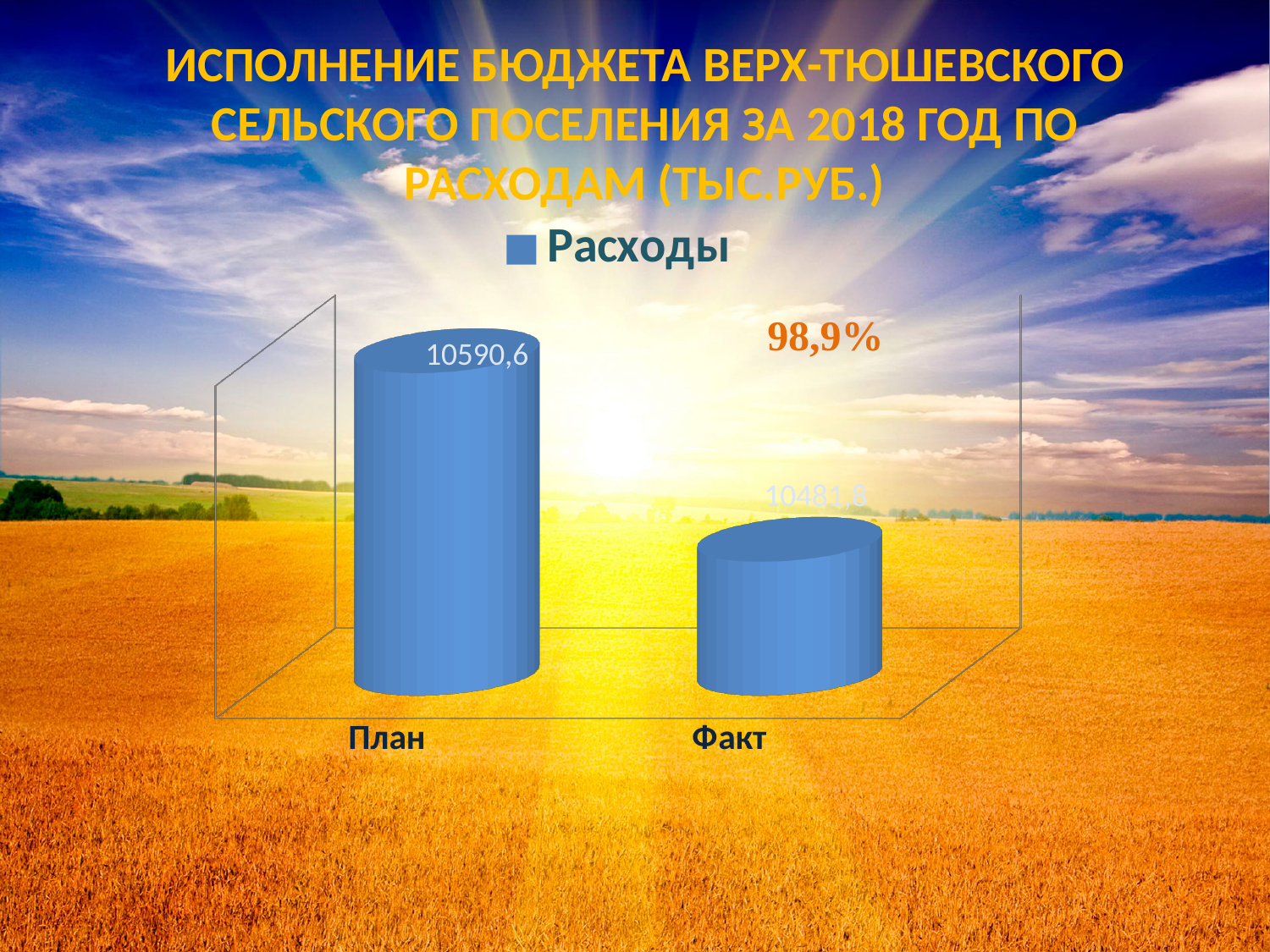
What is the name of the series shown in the legend? Расходы What is the value for Факт? 10481,8 Which category has the higher value, План or Факт? План Which category has the lowest value? Факт Do the values fall or rise from План to Факт? Fall What is the value for План? 10590,6 How many categories are shown on the chart? 2 What percentage is printed above the Факт bar? 98,9% Which category has the highest value? План How many series does the legend list? 1 What is the difference between the values for План and Факт? 108,8 What kind of chart is shown on the slide? Bar chart